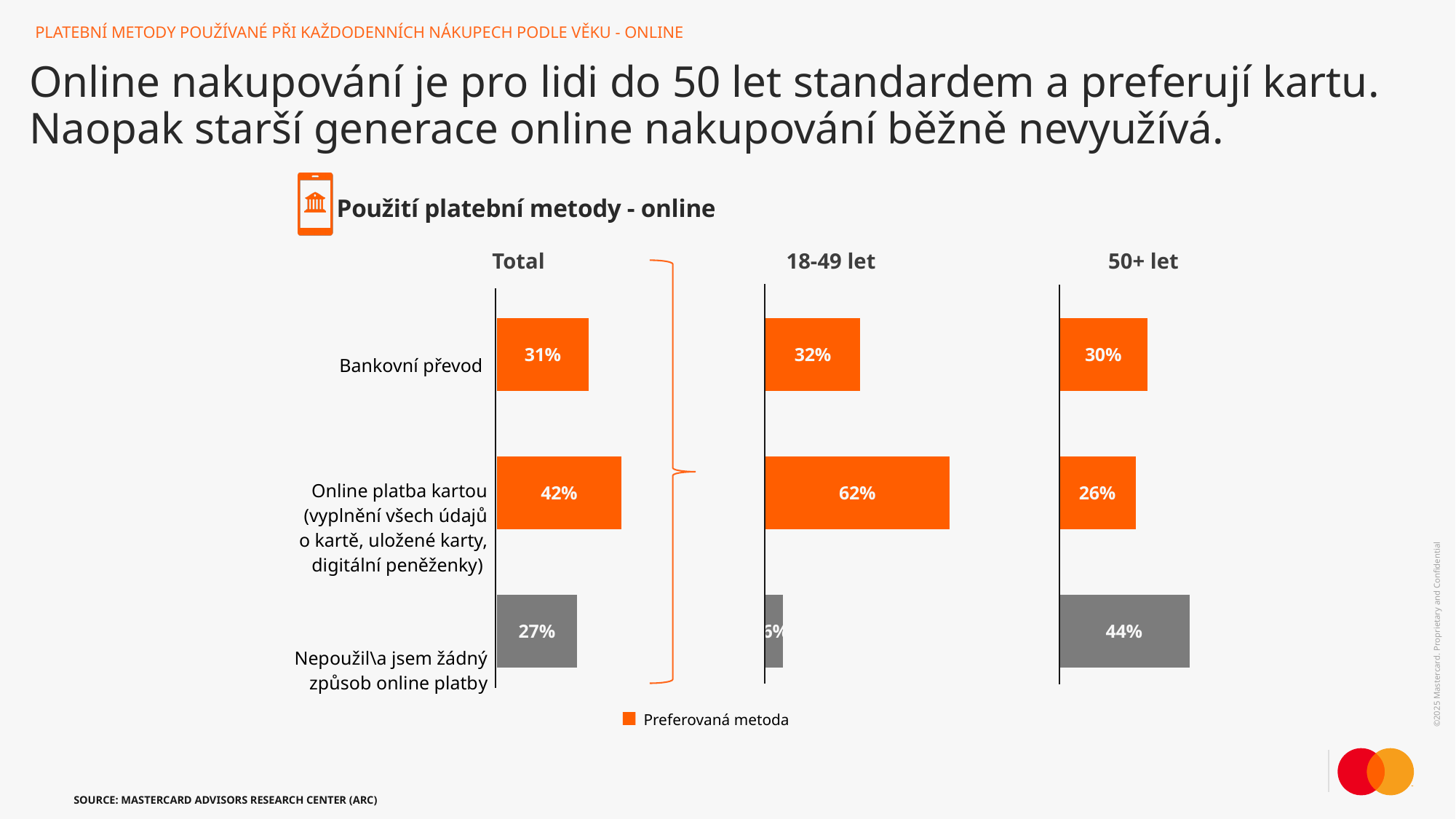
Which is larger: Nepoužil\a jsem žádný způsob online platby in the Total chart or in the 50+ let chart? 50+ let In the 50+ let chart, which category has the lowest value? Online platba kartou In the 50+ let chart, what is the value for Bankovní převod? 30% In the Total chart, what is the value for Bankovní převod? 31% In the 18-49 let chart, which category has the lowest value? Nepoužil\a jsem žádný způsob online platby In the 50+ let chart, what is the value for Nepoužil\a jsem žádný způsob online platby? 44% In the Total chart, which category has the highest value? Online platba kartou What is the legend entry shown below the charts? Preferovaná metoda How many categories does the Total chart show? 3 What kind of chart is the 18-49 let chart? bar chart In the 18-49 let chart, what is the value for Online platba kartou? 62% What is the difference between the Online platba kartou values in the 18-49 let chart and the 50+ let chart? 36%